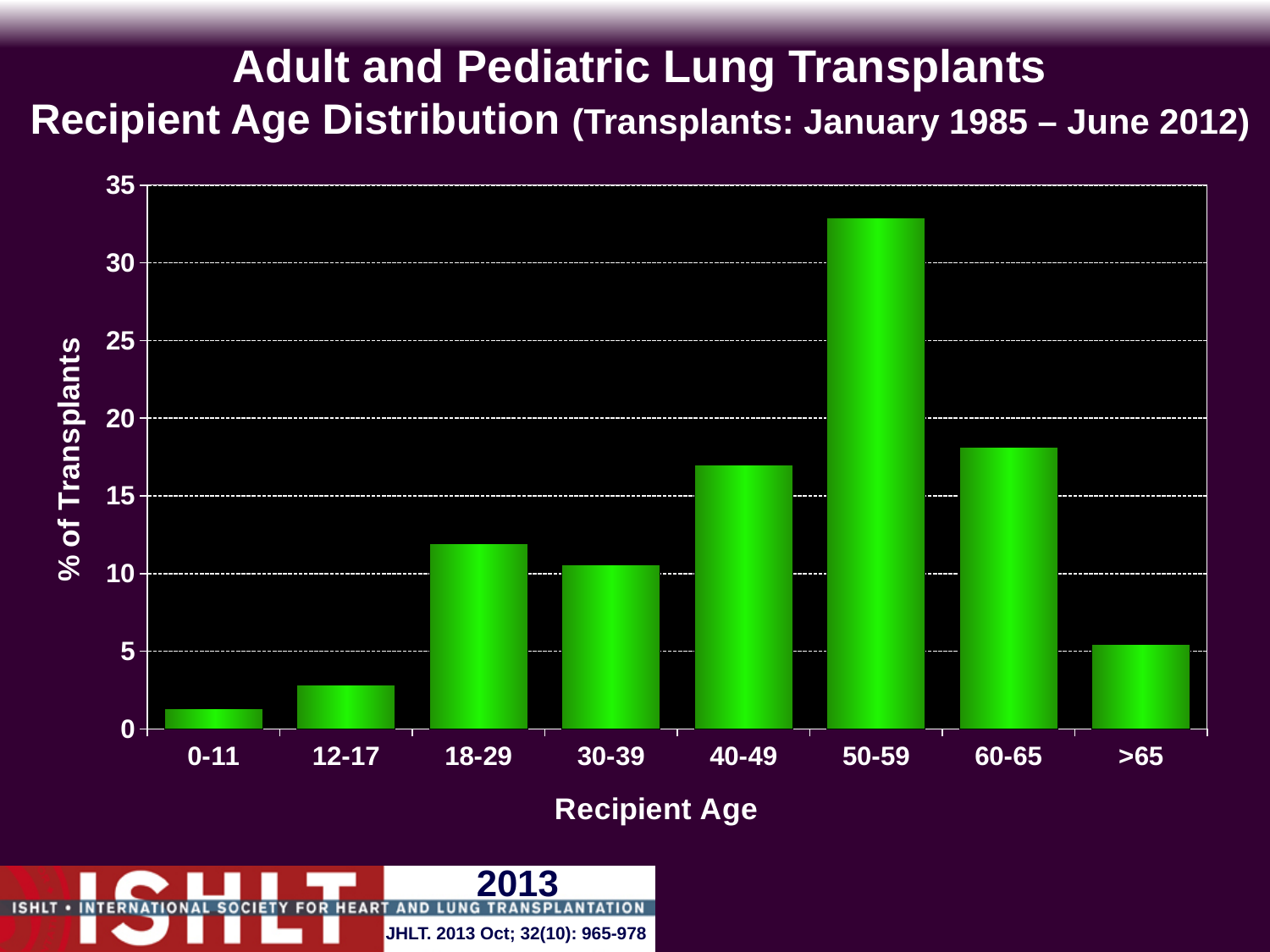
Which age group has a higher percentage of transplants, 60-65 or 40-49? 60-65 Is the value for the 12-17 age group greater or less than 5? less Which age group has a higher percentage of transplants, 18-29 or 30-39? 18-29 Which recipient age group has the highest percentage of transplants? 50-59 Is the value for the 40-49 age group greater or less than 15? greater What kind of chart is shown on the slide? bar chart Which recipient age group has the lowest percentage of transplants? 0-11 Is the value for the 50-59 age group greater or less than 30? greater What is the label of the y axis? % of Transplants How many recipient age categories are shown on the x axis? 8